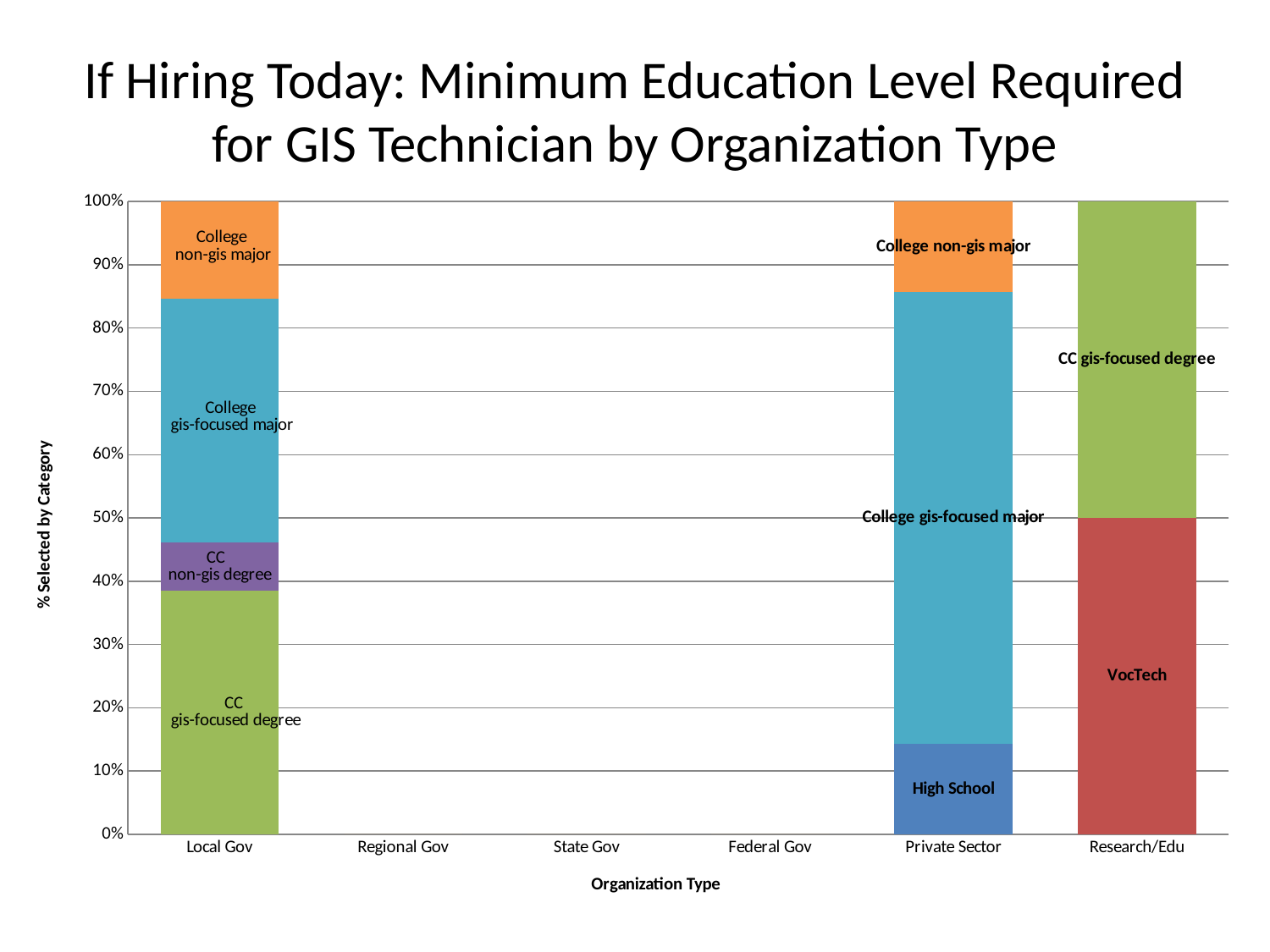
Is the High School share for Private Sector greater or less than 20%? less What share does VocTech make up of the Research/Edu bar? 50% What is the label of the y axis? % Selected by Category Is the CC gis-focused degree share for Local Gov greater or less than 40%? less How many organization types are listed along the x axis? 6 How many organization types have a bar plotted? 3 Which is larger: the CC gis-focused degree share for Local Gov or for Research/Edu? Research/Edu What share does CC gis-focused degree make up of the Research/Edu bar? 50% What kind of chart is shown on the slide? Stacked bar chart Which organization types have no bar plotted? Regional Gov, State Gov, Federal Gov Which education level makes up the largest share of the Private Sector bar? College gis-focused major Is the High School share for Private Sector greater or less than 10%? greater